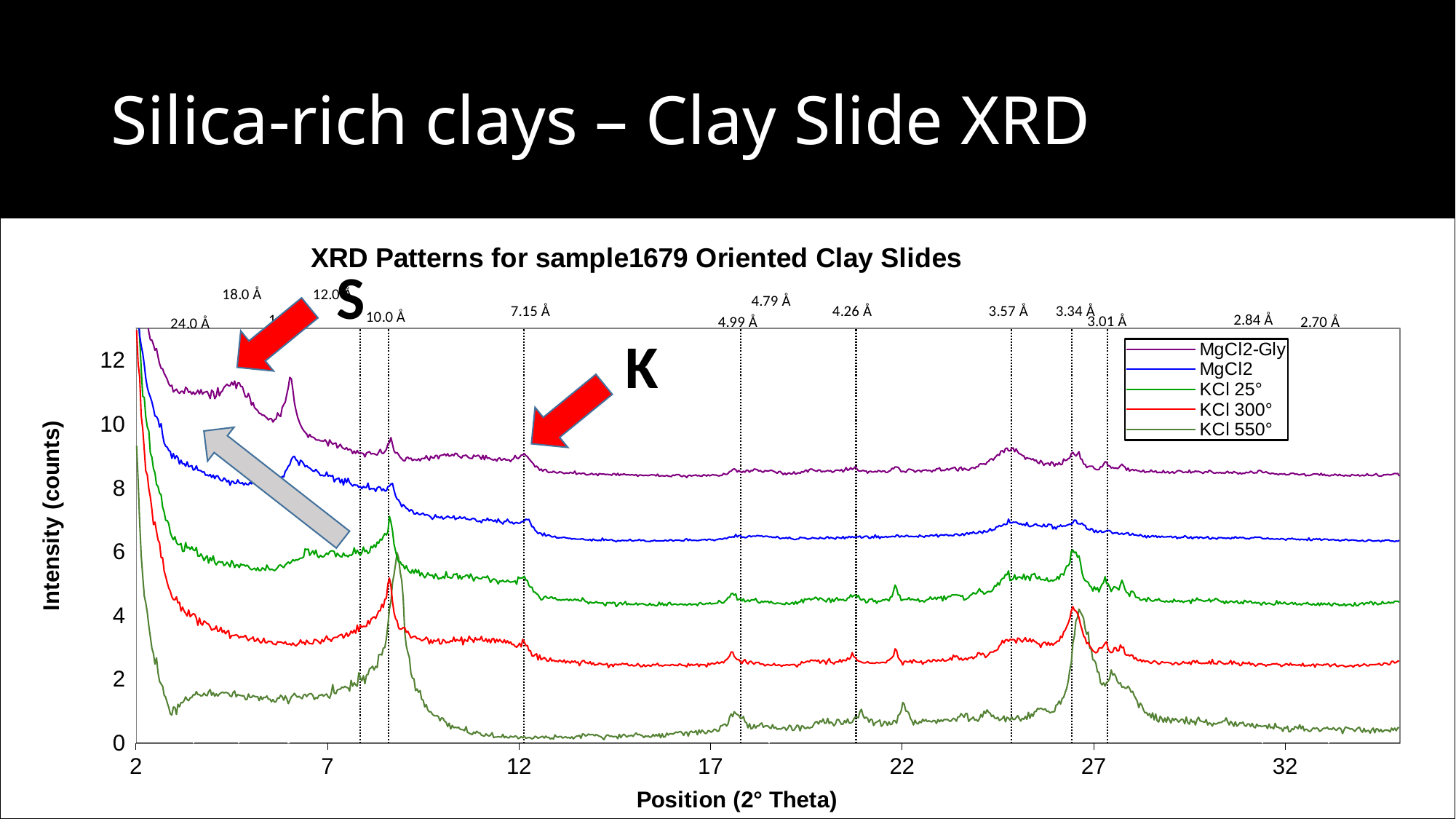
Does the MgCl2 series rise or fall between positions 2 and 7? fall Is the intensity of the KCl 300° series at position 17 greater or less than 4? less What colour is the KCl 25° line? green What is the title of the chart? XRD Patterns for sample1679 Oriented Clay Slides How many series does the legend list? 5 Which series has the highest intensity at position 32? MgCl2-Gly Is the intensity of the MgCl2-Gly series at position 32 greater or less than 8? greater Is the intensity of the KCl 550° series at position 32 greater or less than 2? less What kind of chart is shown on the slide? line chart Which series has the lowest intensity at position 32? KCl 550° At position 22, which series has the higher intensity, MgCl2-Gly or KCl 550°? MgCl2-Gly